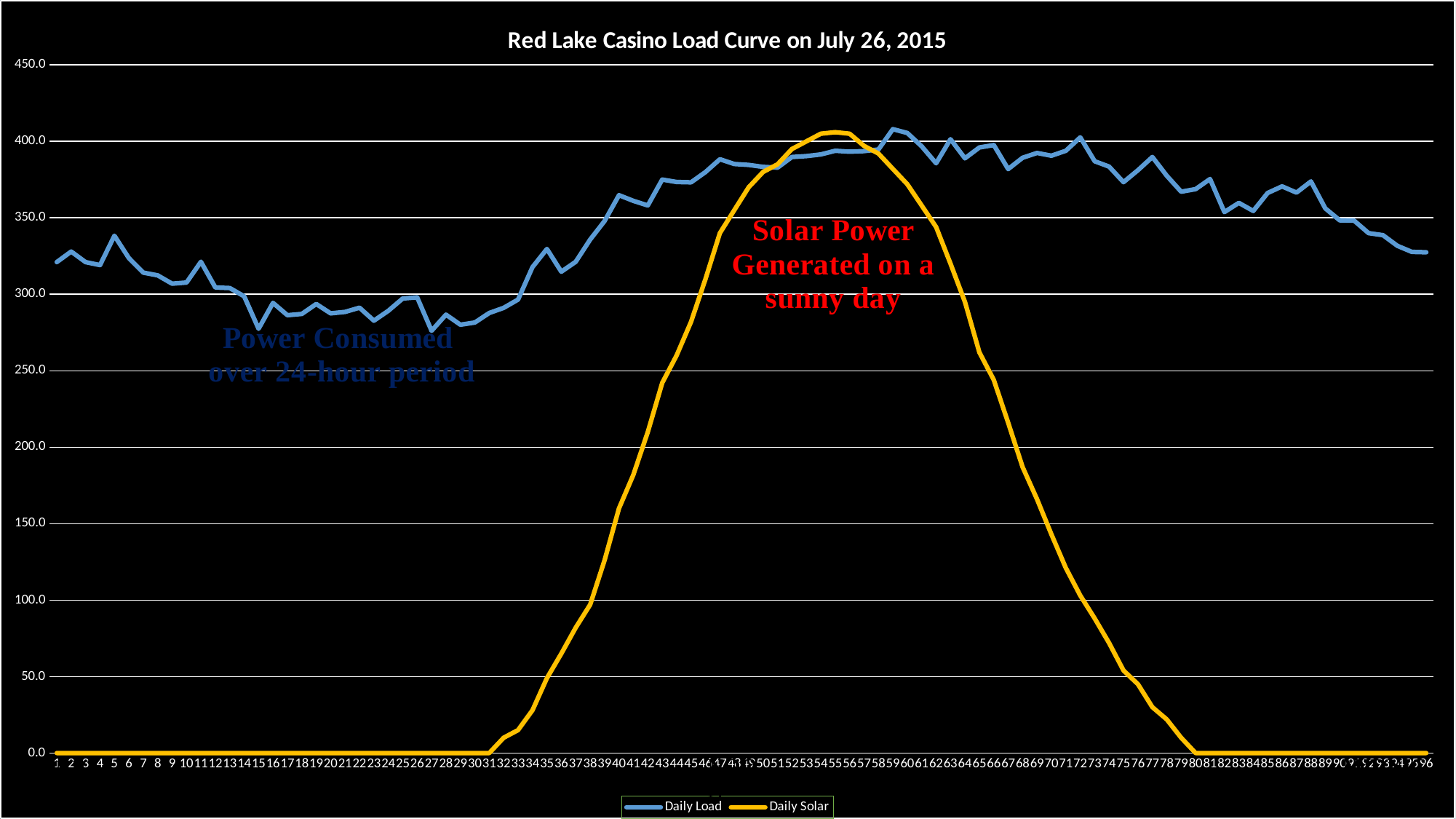
Is the Daily Load value at point 15 greater or less than 300? less Is the Daily Solar value at point 70 greater or less than 200? less Is the Daily Solar value at point 40 greater or less than 100? greater How many series does the legend list? 2 At point 20 on the x axis, which series has the larger value, Daily Load or Daily Solar? Daily Load Which colour is used for the Daily Solar series? yellow Does the Daily Solar series rise or fall between point 60 and point 80 on the x axis? fall What kind of chart is shown on the slide? line chart What is the Daily Solar value at point 10 on the x axis? 0.0 What is the title of the chart? Red Lake Casino Load Curve on July 26, 2015 What is the Daily Solar value at point 90 on the x axis? 0.0